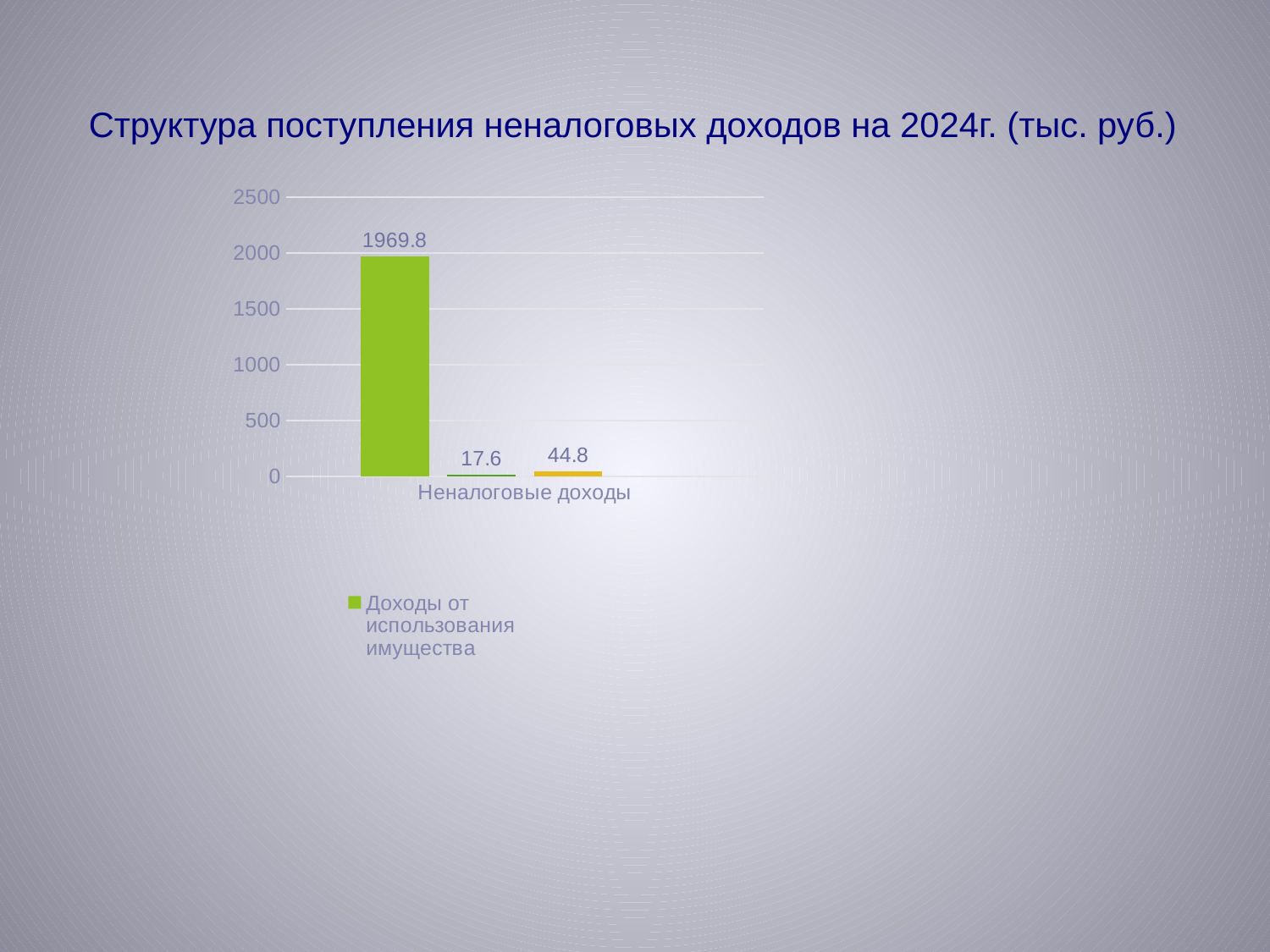
What is the lowest value plotted on the chart? 17.6 Is the value for "Доходы от использования имущества" greater or less than 1500? greater What type of chart is shown on the slide? bar chart How many bars are plotted on the chart? 3 What is the highest value plotted on the chart? 1969.8 What is the difference between the tallest bar (1969.8) and the yellow bar (44.8)? 1925.0 How many series does the legend list? 1 What is the value of the bar for "Доходы от использования имущества"? 1969.8 Which is larger: the yellow bar or the bar labelled 17.6? the yellow bar What is the category label shown on the x axis? Неналоговые доходы What is the difference between the yellow bar (44.8) and the smallest bar (17.6)? 27.2 What is the value shown on the yellow bar? 44.8